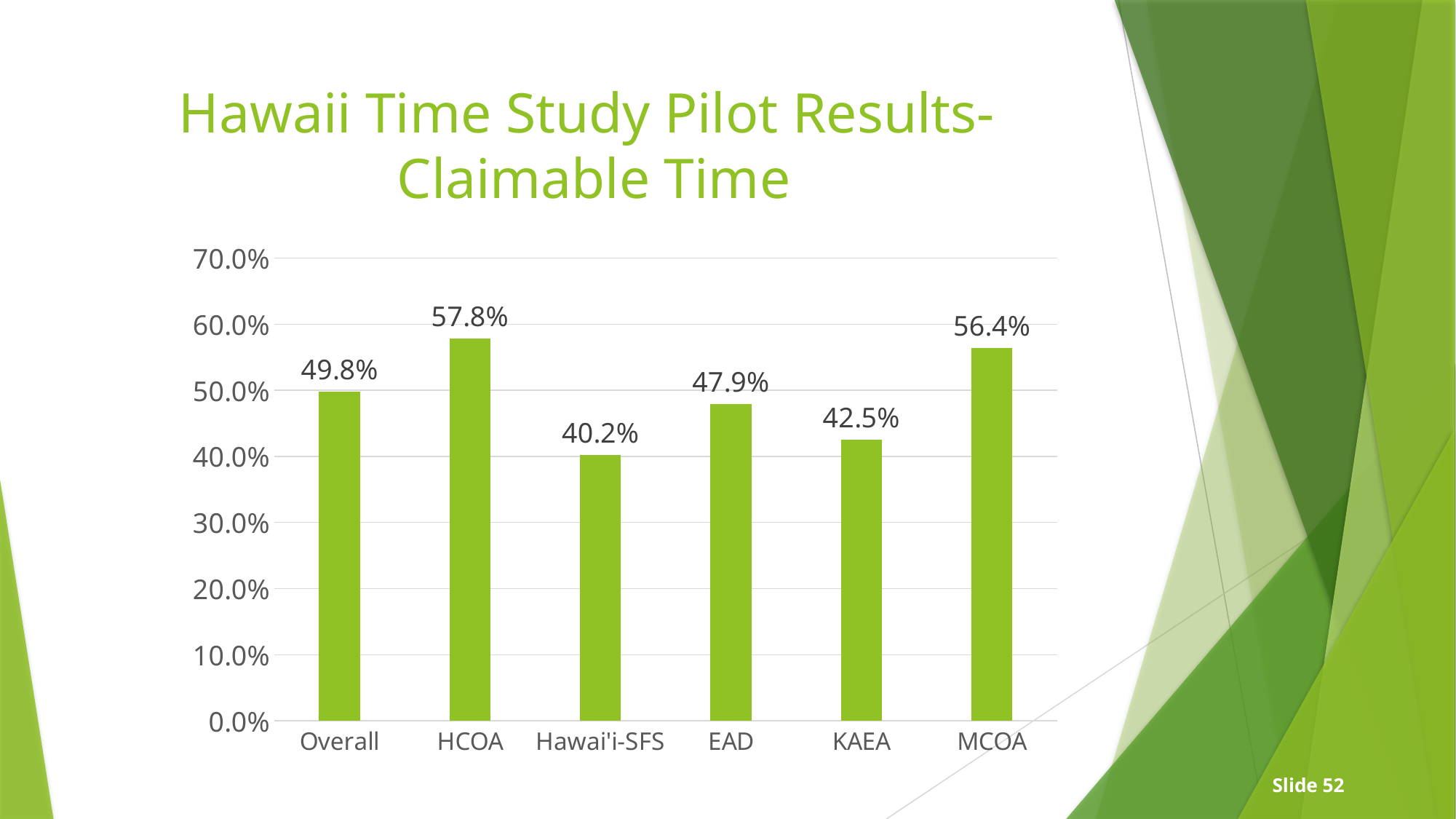
Which category has the highest claimable time percentage? HCOA What kind of chart is shown on the slide? Bar chart Which category has the lowest claimable time percentage? Hawai'i-SFS What is the claimable time percentage for KAEA? 42.5% What is the title of the slide? Hawaii Time Study Pilot Results- Claimable Time How many categories are shown on the x axis? 6 What is the claimable time percentage for HCOA? 57.8% Which has a higher claimable time percentage, EAD or KAEA? EAD What is the Overall claimable time percentage? 49.8% What is the claimable time percentage for Hawai'i-SFS? 40.2% What is the difference in percentage points between MCOA and KAEA? 13.9 What is the difference in percentage points between HCOA and Hawai'i-SFS? 17.6